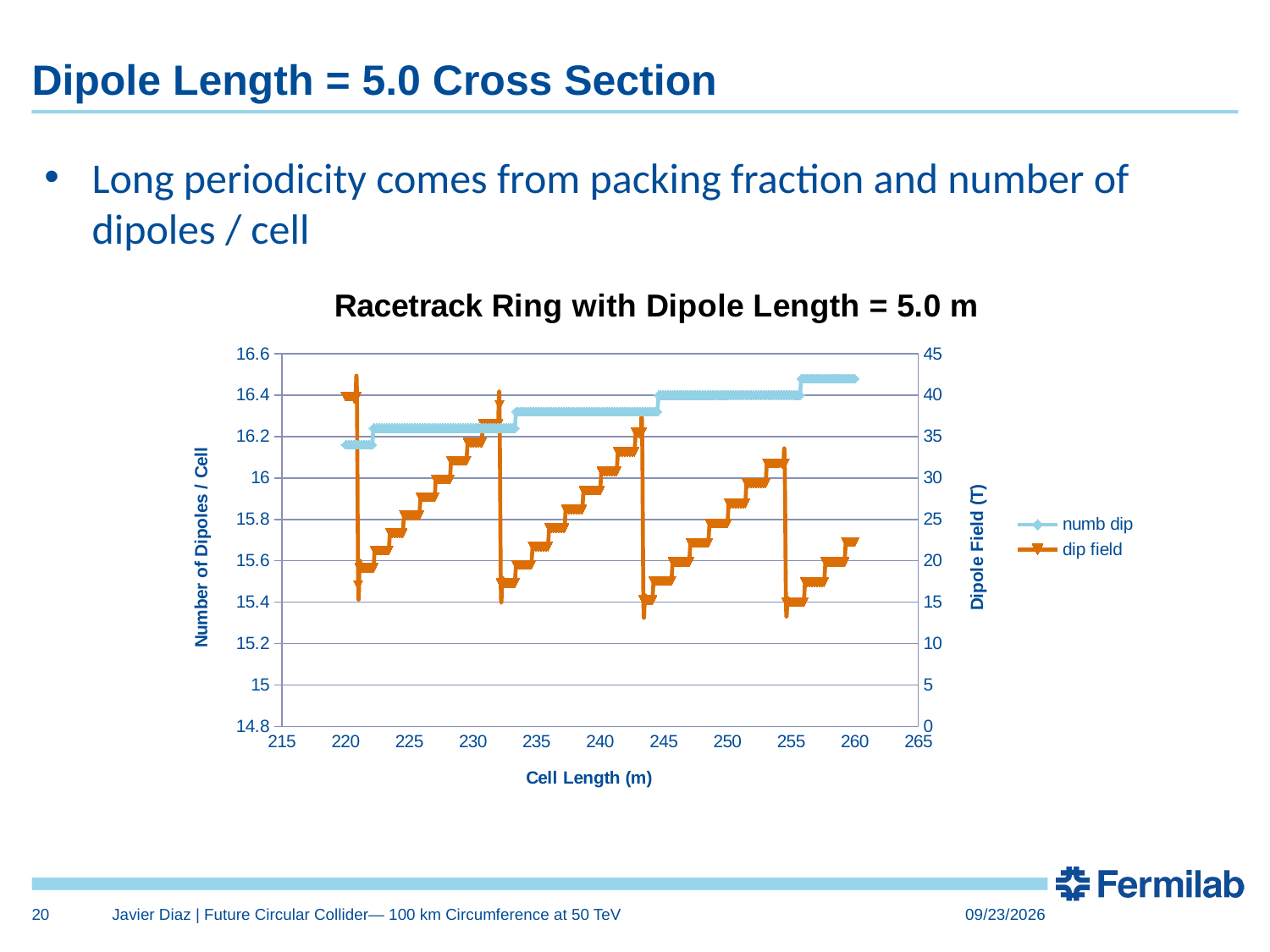
What is the title of the chart? Racetrack Ring with Dipole Length = 5.0 m What kind of chart is shown on the slide? line chart Which is larger for the dip field series: the value at a cell length of 230 m or at 245 m? 230 m How many series does the chart legend list? 2 Does the numb dip series rise or fall as cell length increases along the x axis? rise Is the numb dip value at a cell length of 258 m greater or less than 16.4? greater Is the dip field value at a cell length of 245 m greater or less than 20? less Which is larger for the numb dip series: the value at a cell length of 220 m or at 258 m? 258 m Is the dip field value at a cell length of 255 m greater or less than 20? less What is the label of the x axis of the chart? Cell Length (m)